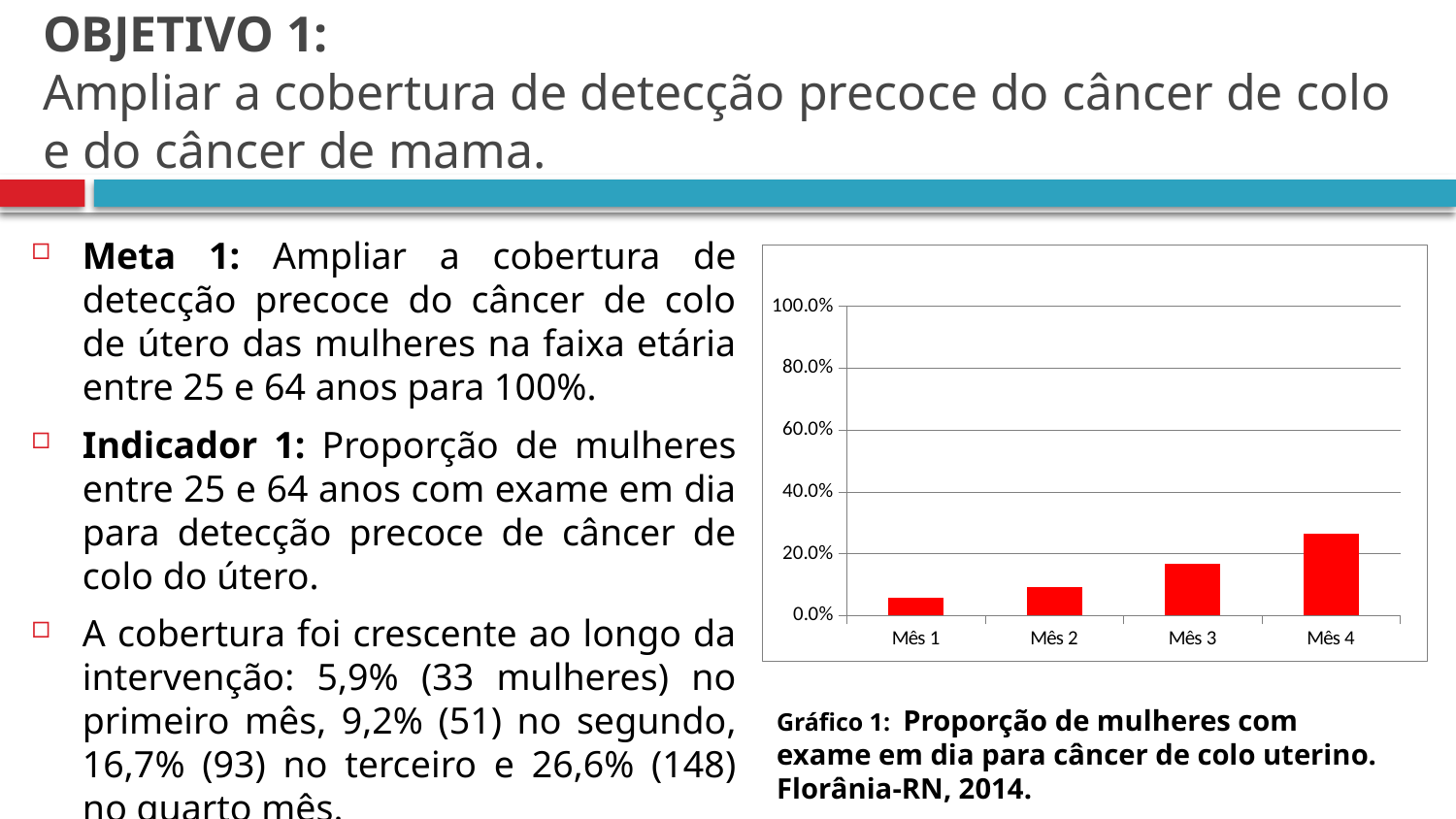
What colour are the bars in the chart? red How many categories (months) are plotted on the chart? 4 Is the value for Mês 1 greater or less than 20.0%? less Is the value for Mês 4 greater or less than 40.0%? less Which month has the lowest value in the chart? Mês 1 Is the value for Mês 4 greater or less than 20.0%? greater What kind of chart is shown on the slide? bar chart What is the highest value shown on the chart's vertical axis? 100.0% Do the values rise or fall from Mês 1 to Mês 4? rise Which month has the highest value in the chart? Mês 4 Which is larger, the value for Mês 2 or the value for Mês 3? Mês 3